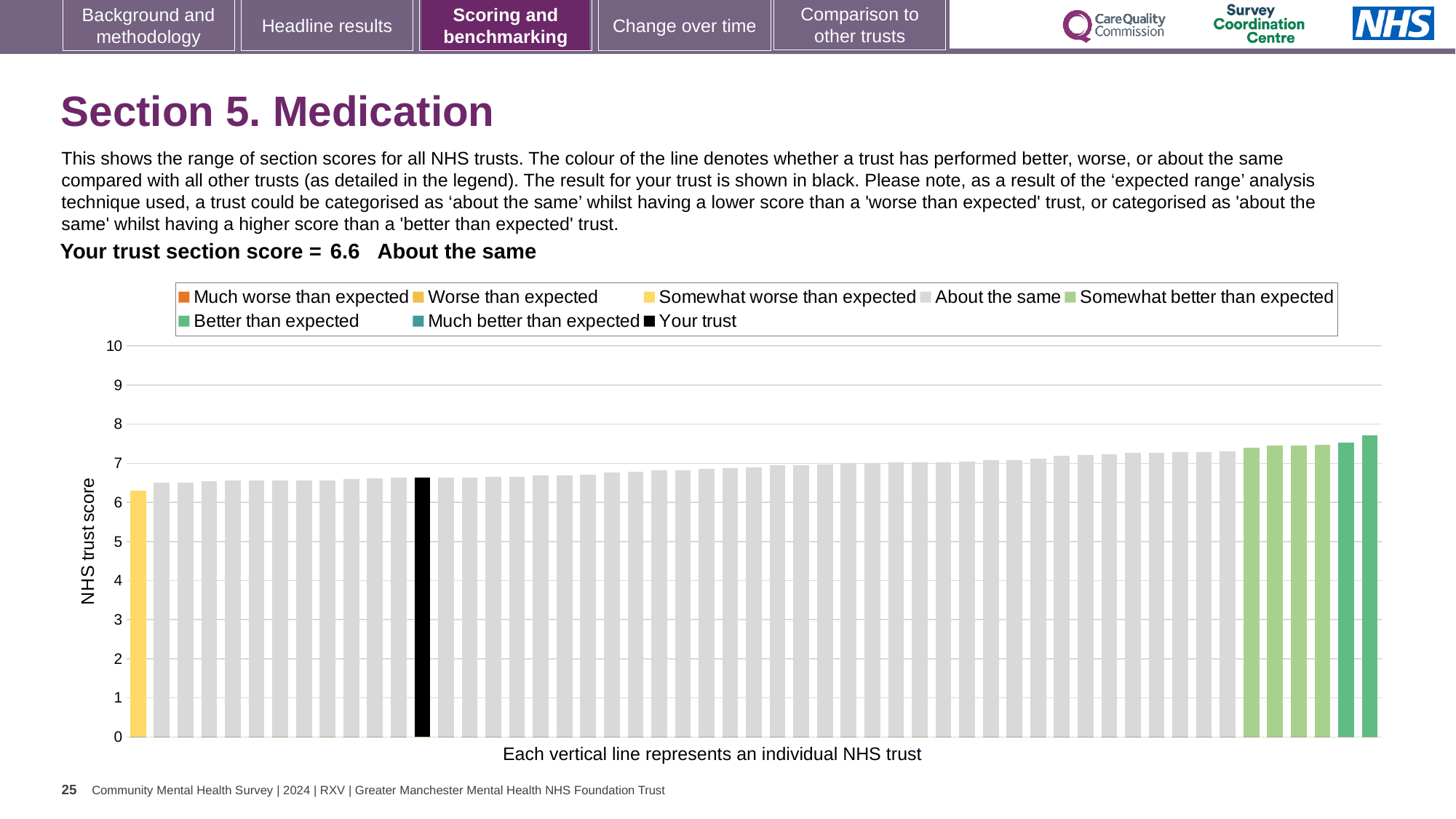
What colour is the bar representing your trust? Black Which is higher, the rightmost bar or the black bar for your trust? The rightmost bar What is the section score for your trust shown on the slide? 6.6 What is the label on the vertical axis of the chart? NHS trust score Is the value for the rightmost bar greater or less than 7? greater What type of chart is shown on the slide? Bar chart Is the value for the rightmost bar greater or less than 8? less Which category is your trust placed in for Section 5 Medication? About the same How many entries does the chart legend list? 8 Is the value for your trust's bar greater or less than 5? greater Do the trust scores rise or fall moving from left to right along the x axis? Rise